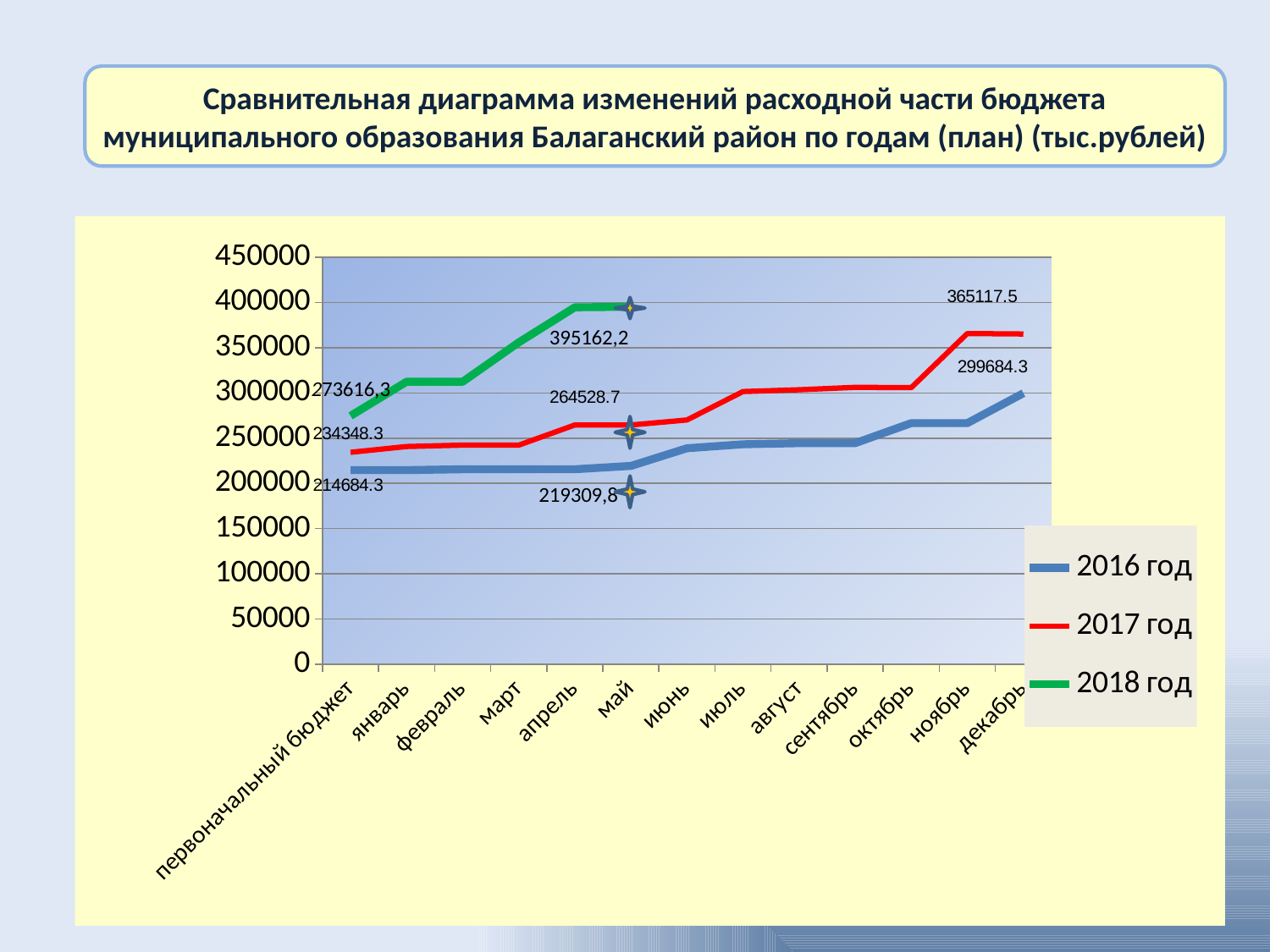
What is the value of the 2016 год series for декабрь? 299684.3 What is the value of the 2017 год series for декабрь? 365117.5 How many series does the legend list? 3 Does the 2016 год series rise or fall from первоначальный бюджет to декабрь? rise Is the value of the 2017 год series for июль greater or less than 250000? greater What is the value of the 2018 год series for первоначальный бюджет? 273616,3 What is the value of the 2017 год series for первоначальный бюджет? 234348.3 What is the value of the 2016 год series for первоначальный бюджет? 214684.3 Which series has the highest value for май? 2018 год How many categories are shown on the x axis? 13 What is the value of the 2018 год series for май? 395162,2 What kind of chart is shown on the slide? line chart